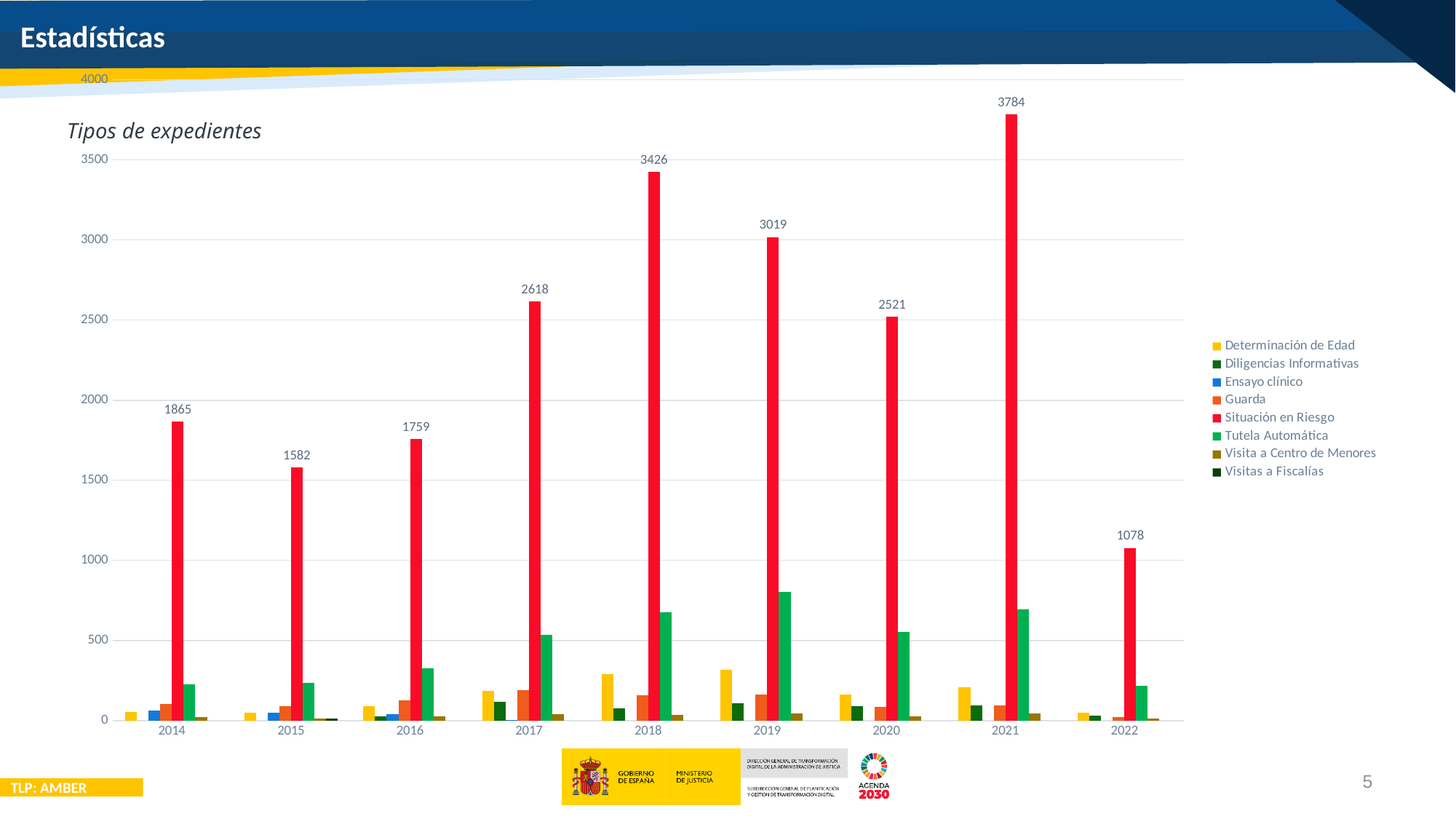
In which year is the Situación en Riesgo value highest? 2021 Which is larger, the Situación en Riesgo value for 2017 or for 2020? 2017 Is the value for Determinación de Edad in 2018 greater or less than 500? less How many series does the legend list? 8 What is the value for Situación en Riesgo in 2014? 1865 What is the value for Situación en Riesgo in 2021? 3784 In which year is the Situación en Riesgo value lowest? 2022 What is the value for Situación en Riesgo in 2022? 1078 What kind of chart is shown on the slide? Bar chart How many years are shown on the x axis? 9 Is the value for Tutela Automática in 2019 greater or less than 500? greater What is the difference between the Situación en Riesgo values for 2018 and 2019? 407